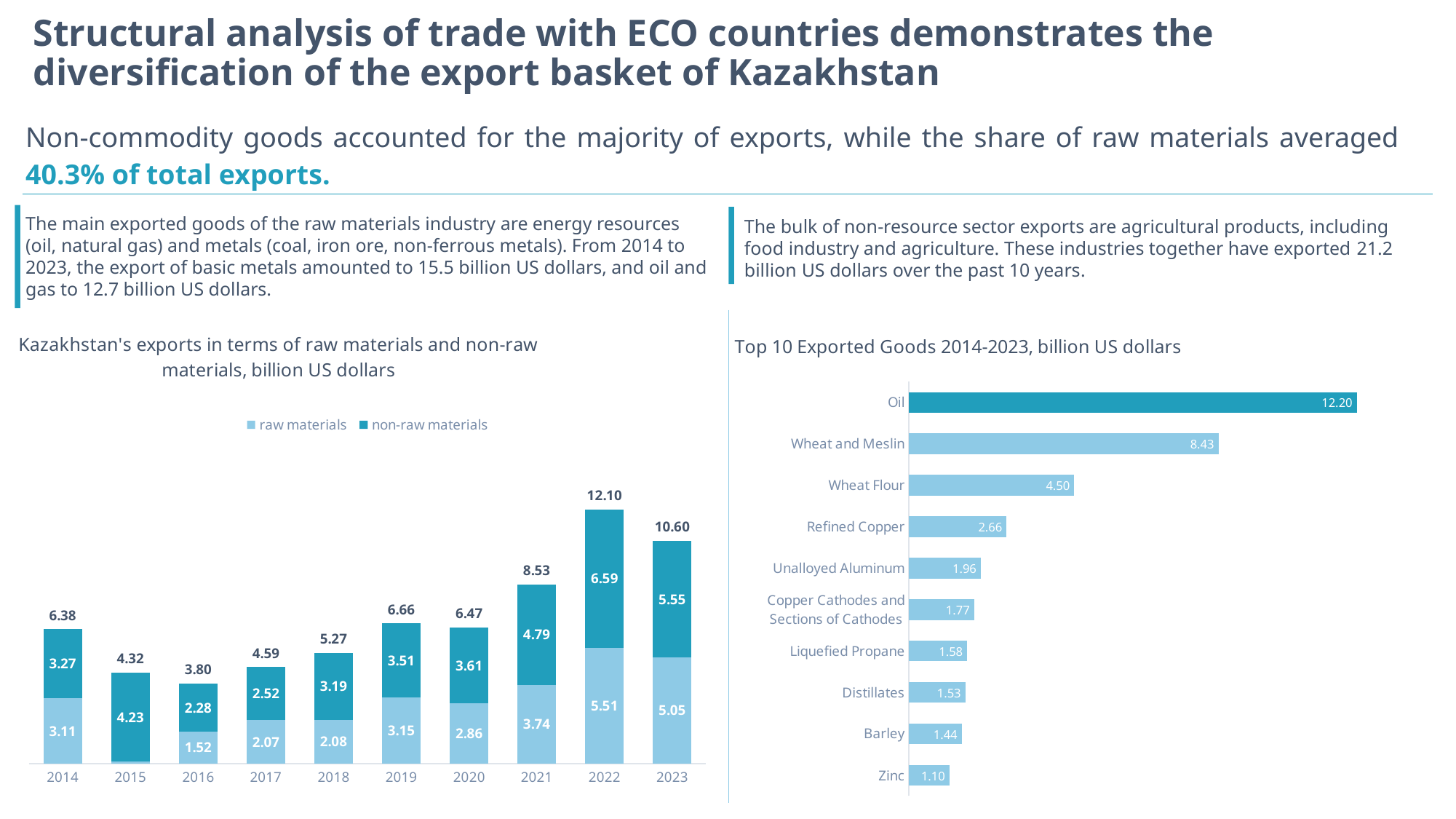
In the chart 'Kazakhstan's exports in terms of raw materials and non-raw materials', what is the value for raw materials in 2021? 3.74 In the chart 'Top 10 Exported Goods 2014-2023', what is the value for Wheat Flour? 4.50 In the chart 'Kazakhstan's exports in terms of raw materials and non-raw materials', how many years are shown on the x axis? 10 In the chart 'Top 10 Exported Goods 2014-2023', what is the difference between Oil and Wheat and Meslin? 3.77 In the chart 'Top 10 Exported Goods 2014-2023', which is larger, Refined Copper or Unalloyed Aluminum? Refined Copper In the chart 'Kazakhstan's exports in terms of raw materials and non-raw materials', how many series does the legend list? 2 In the chart 'Top 10 Exported Goods 2014-2023', which good has the highest value? Oil What kind of chart is 'Top 10 Exported Goods 2014-2023'? Bar chart In the chart 'Kazakhstan's exports in terms of raw materials and non-raw materials', what is the difference between non-raw materials and raw materials in 2023? 0.50 In the chart 'Kazakhstan's exports in terms of raw materials and non-raw materials', what is the value for non-raw materials in 2019? 3.51 In the chart 'Kazakhstan's exports in terms of raw materials and non-raw materials', what is the total of the stacked bar for 2022? 12.10 In the chart 'Kazakhstan's exports in terms of raw materials and non-raw materials', which year has the lowest total exports? 2016